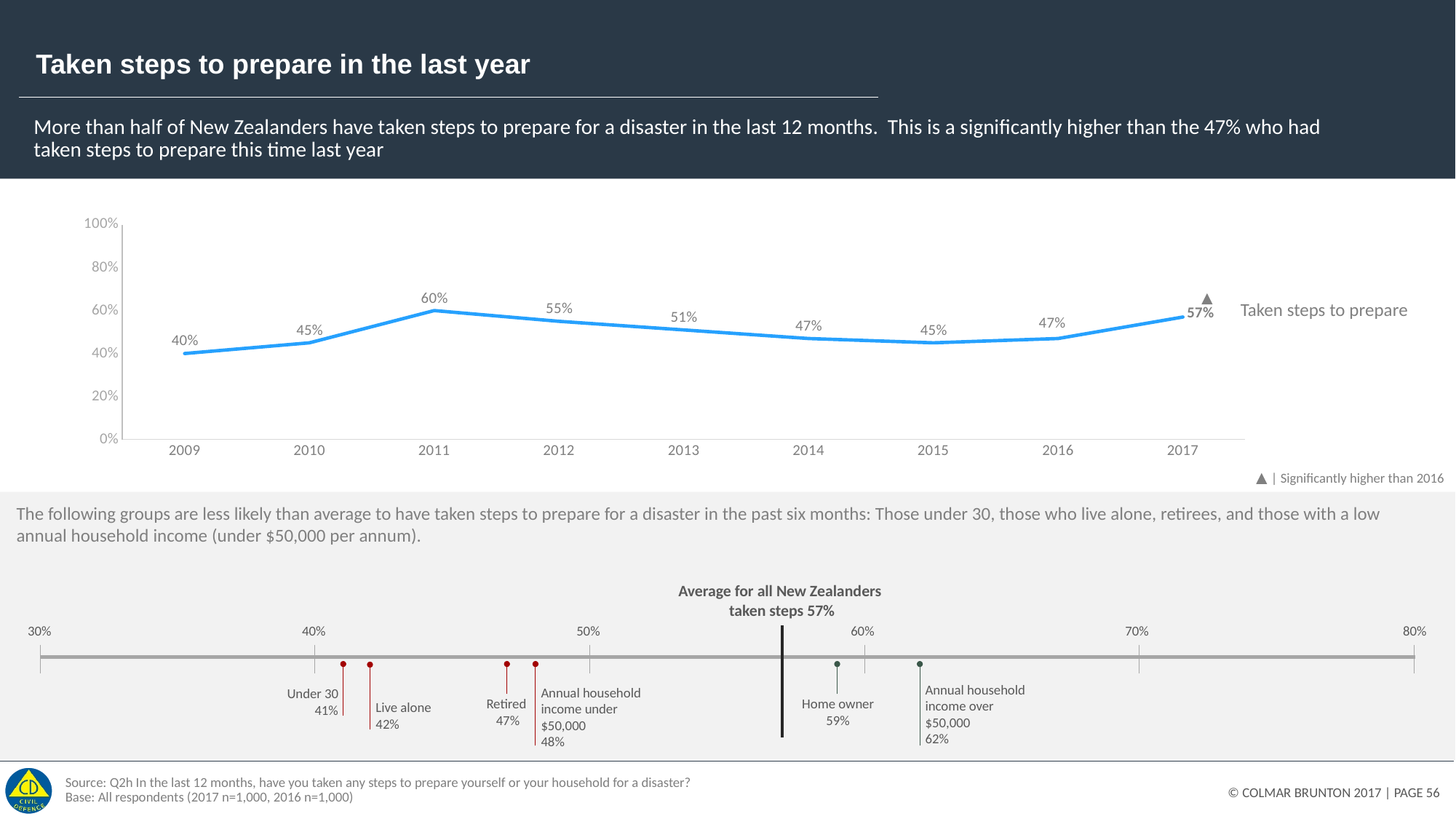
In the bottom chart, what is the value for Home owner? 59% In the line chart, what was the value for 2017? 57% In the bottom chart, what is the difference between Annual household income over $50,000 and Annual household income under $50,000? 14% In the bottom chart, which group has the lowest value? Under 30 In the line chart, which year has the highest value? 2011 In the line chart, which year has the lowest value? 2009 In the line chart, what was the value for 2011? 60% What type of chart is the top chart on the slide? Line chart In the line chart, did the value rise or fall from 2011 to 2015? Fall In the line chart, what is the difference between the 2017 value and the 2016 value? 10% In the line chart, how many years are plotted? 9 In the line chart, which is larger, the value for 2012 or the value for 2013? 2012